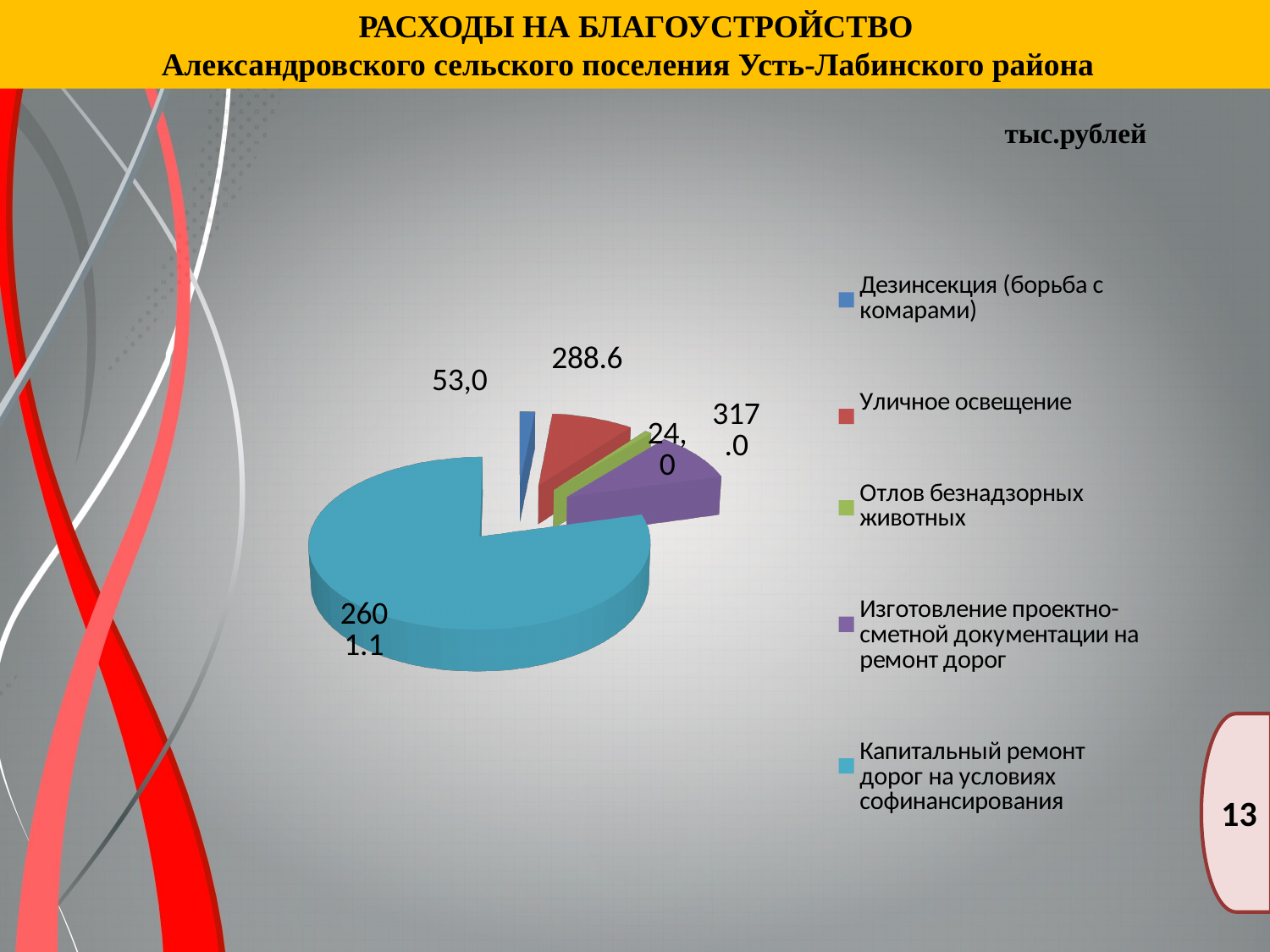
In what units are the values on the chart given? тыс.рублей What type of chart is shown on the slide? pie chart What is the value for Уличное освещение? 288.6 What is the difference between the values for Дезинсекция (борьба с комарами) and Отлов безнадзорных животных? 29,0 Which category has the largest slice of the pie? Капитальный ремонт дорог на условиях софинансирования What is the value for Изготовление проектно-сметной документации на ремонт дорог? 317.0 What is the value for Отлов безнадзорных животных? 24,0 What is the difference between the values for Изготовление проектно-сметной документации на ремонт дорог and Уличное освещение? 28.4 What is the value for Дезинсекция (борьба с комарами)? 53,0 How many slices does the pie chart have? 5 Which category has the smallest slice of the pie? Отлов безнадзорных животных Which is larger: Уличное освещение or Изготовление проектно-сметной документации на ремонт дорог? Изготовление проектно-сметной документации на ремонт дорог